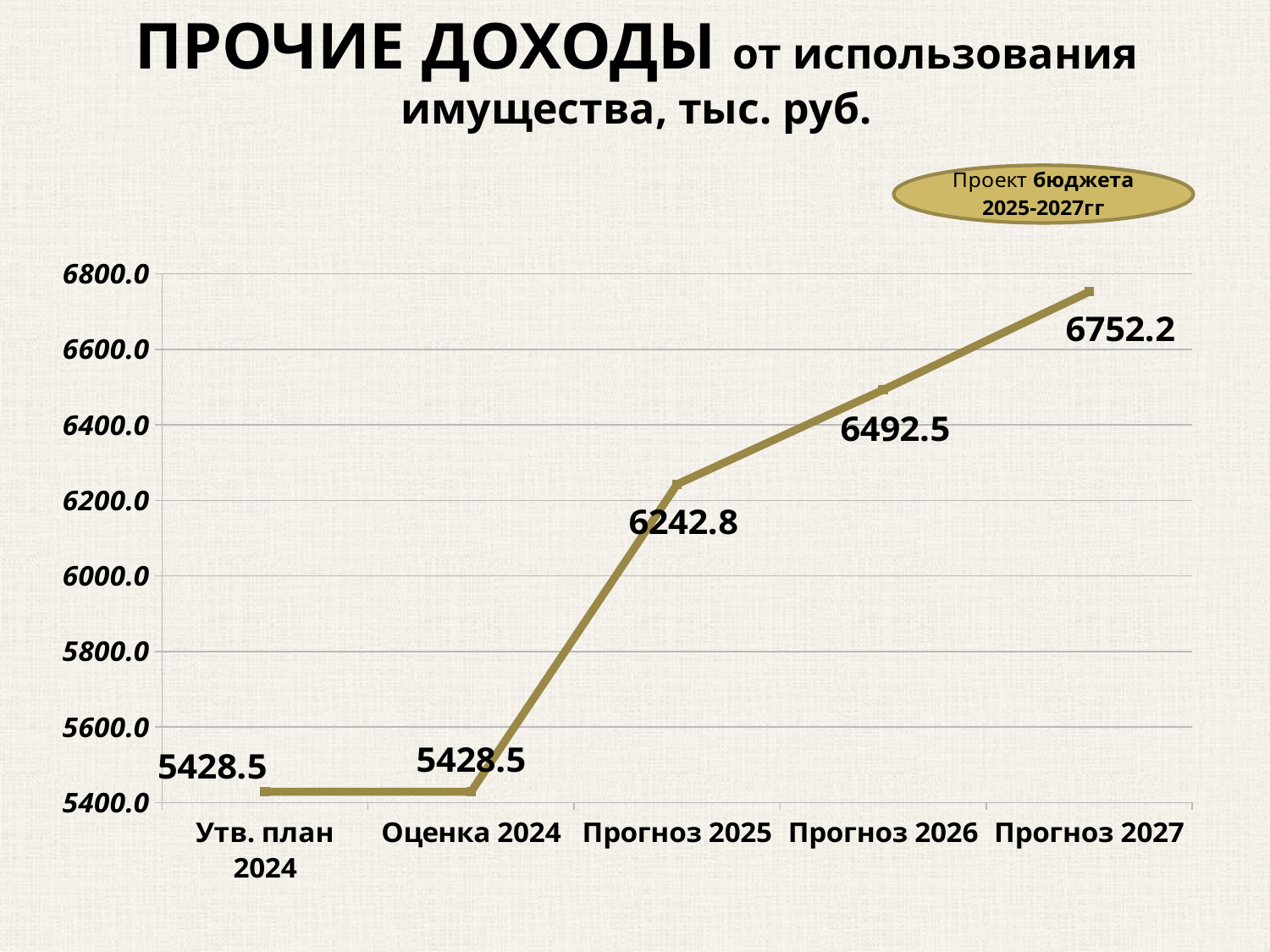
Which is larger, the value for Прогноз 2026 or the value for Прогноз 2025? Прогноз 2026 What is the value for Прогноз 2027? 6752.2 What kind of chart is shown on the slide? line chart Do the values rise or fall from Оценка 2024 to Прогноз 2027? rise What is the value for Оценка 2024? 5428.5 What is the difference between the values for Прогноз 2027 and Прогноз 2026? 259.7 Is the value for Прогноз 2026 greater or less than 6400.0? greater How many data points are plotted on the chart? 5 What is the value for Прогноз 2026? 6492.5 What is the value for Прогноз 2025? 6242.8 What is the difference between the values for Прогноз 2025 and Оценка 2024? 814.3 Which category has the highest value? Прогноз 2027